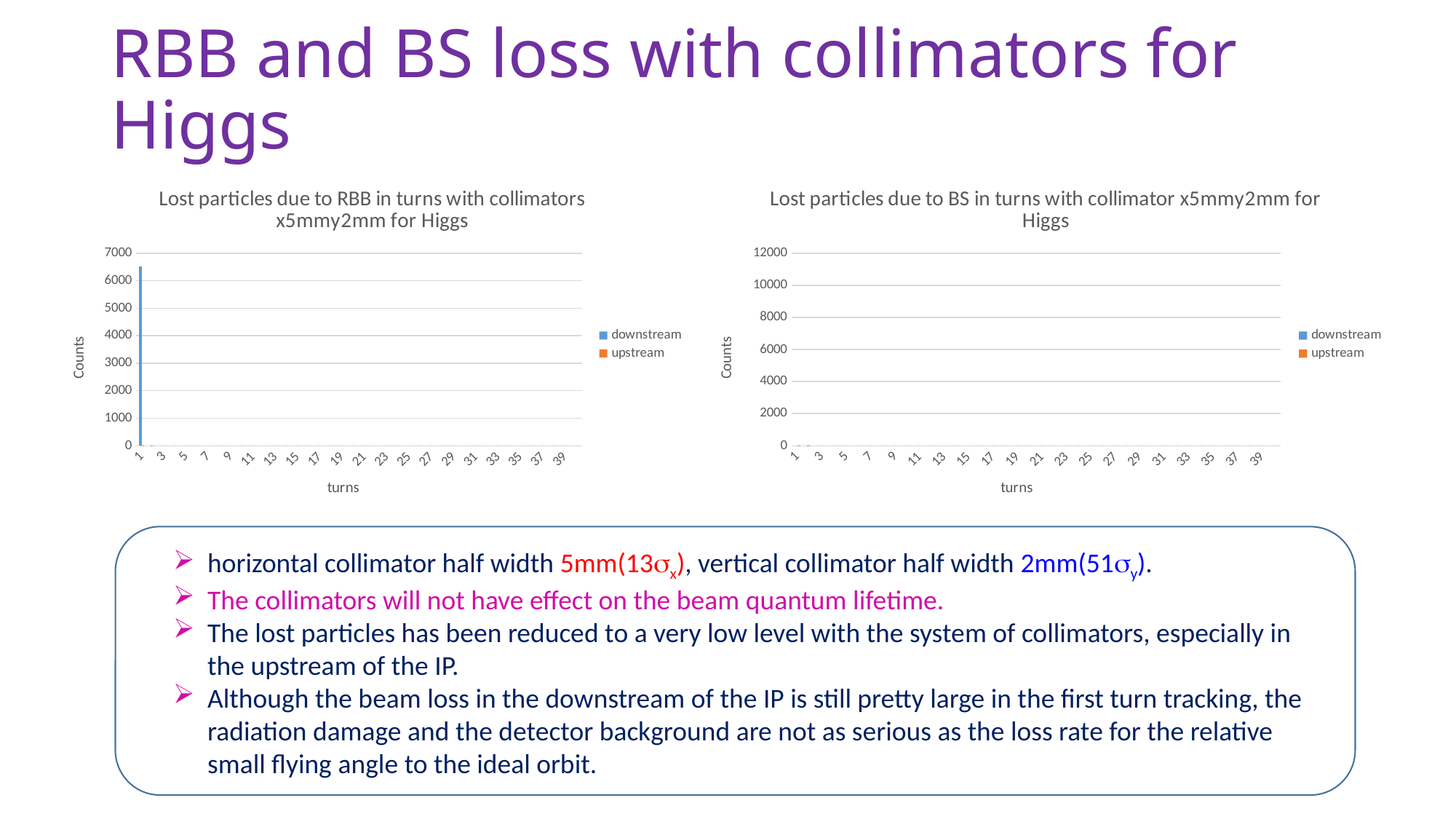
What is the highest tick value shown on the y axis of the left chart (RBB)? 7000 What is the highest tick value shown on the y axis of the right chart (BS)? 12000 How many series does the legend of the right chart (BS) list? 2 In the left chart (RBB), at turn 1, which series is larger, downstream or upstream? downstream In the left chart (RBB), do the downstream counts rise or fall as the turns increase along the x axis? fall In the right chart (BS), is the downstream value at turn 1 greater or less than 2000? less What kind of chart is the left chart, 'Lost particles due to RBB in turns with collimators x5mmy2mm for Higgs'? bar chart How many series does the legend of the left chart (RBB) list? 2 In the left chart (RBB), at which turn is the downstream count highest? 1 In the left chart (RBB), is the downstream value at turn 1 greater or less than 7000? less In the left chart (RBB), is the downstream value at turn 1 greater or less than 6000? greater What are the two series named in the legend of the right chart (BS)? downstream, upstream